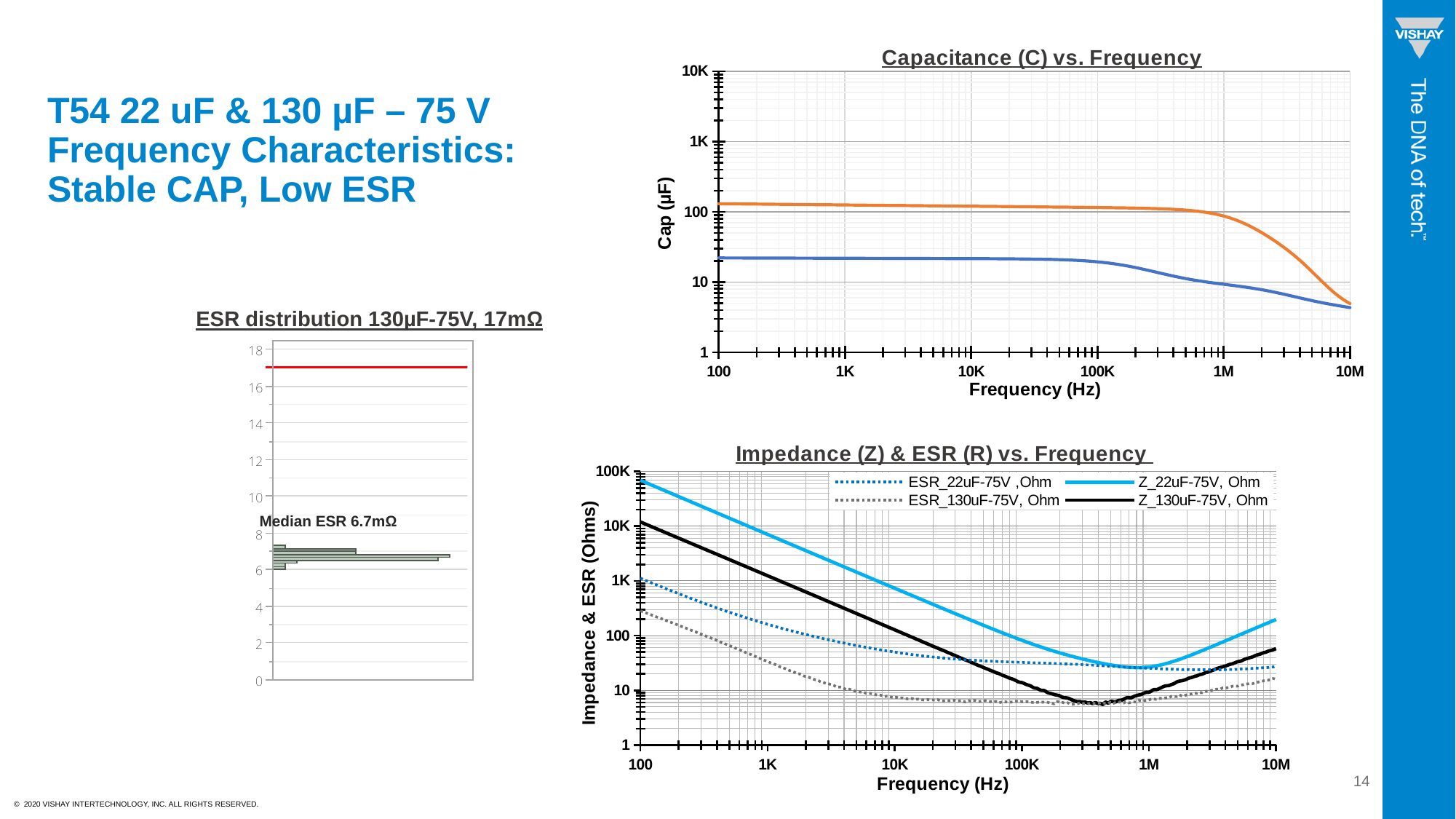
On the "Impedance (Z) & ESR (R) vs. Frequency" chart, is the value of Z_22uF-75V at 100 Hz greater or less than 10K Ohms? greater How many lines are plotted on the "Capacitance (C) vs. Frequency" chart? 2 How many series does the legend of the "Impedance (Z) & ESR (R) vs. Frequency" chart list? 4 On the "Impedance (Z) & ESR (R) vs. Frequency" chart, is the value of ESR_130uF-75V at 100 Hz greater or less than 1K Ohms? less On the "Impedance (Z) & ESR (R) vs. Frequency" chart, which is larger at 100 Hz: Z_22uF-75V or Z_130uF-75V? Z_22uF-75V What is the y-axis label of the "Impedance (Z) & ESR (R) vs. Frequency" chart? Impedance & ESR (Ohms) On the "Capacitance (C) vs. Frequency" chart, do the capacitance values rise or fall as frequency increases toward 10M Hz? fall On the "Capacitance (C) vs. Frequency" chart, is the value of the blue line at 100 Hz greater or less than 100 µF? less What median ESR value is stated on the "ESR distribution 130µF-75V, 17mΩ" chart? 6.7mΩ What kind of chart is the "ESR distribution 130µF-75V, 17mΩ" chart? bar chart What kind of chart is the "Capacitance (C) vs. Frequency" chart? line chart